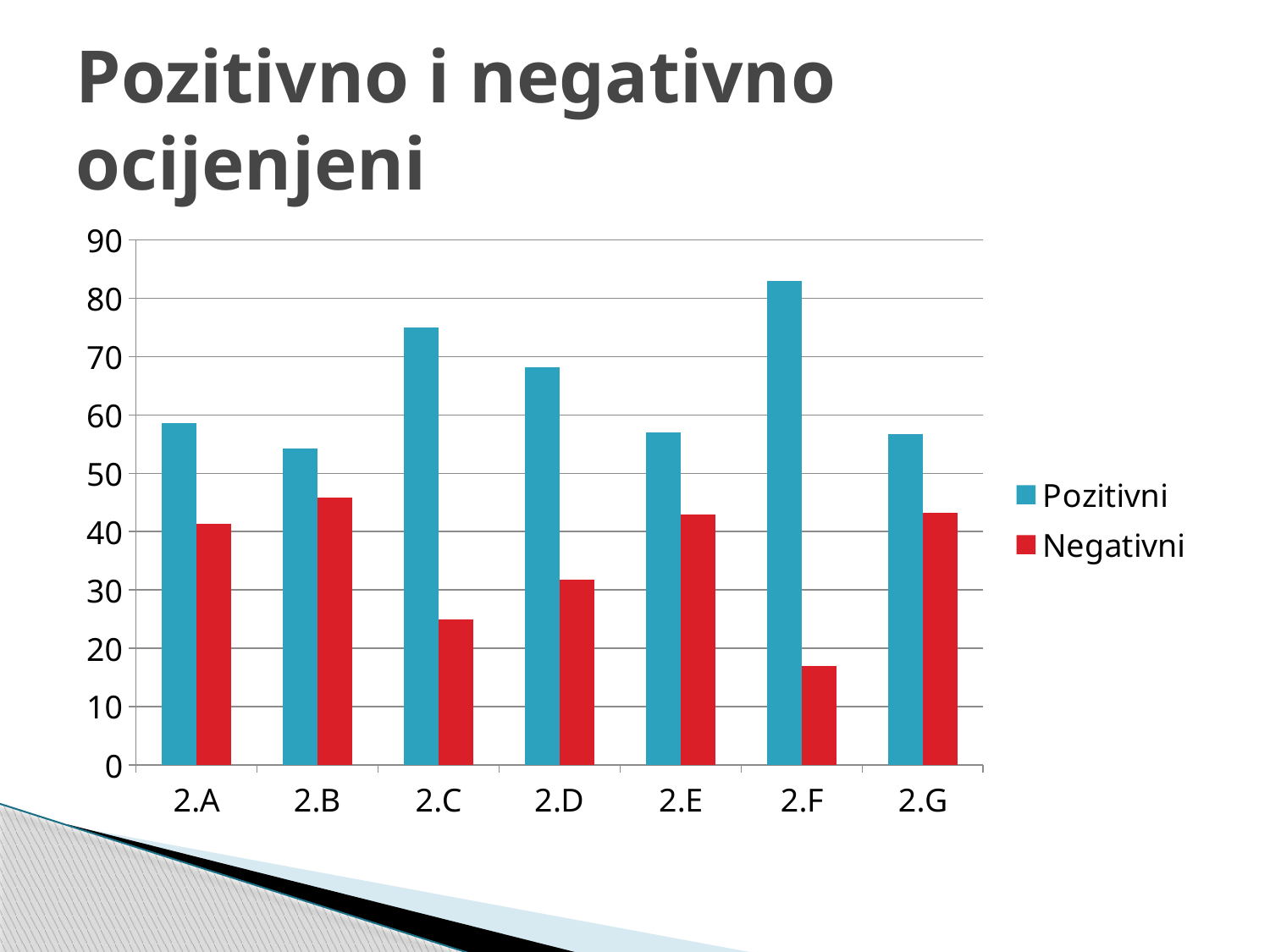
How many series does the legend list? 2 Which category has the lowest Negativni value? 2.F Which is larger, the Pozitivni value for 2.C or for 2.D? 2.C Is the Negativni value for 2.F greater or less than 20? less Is the Pozitivni value for 2.C greater or less than 70? greater Which is larger, the Negativni value for 2.B or for 2.C? 2.B Is the Pozitivni value for 2.F greater or less than 80? greater How many categories are shown on the x axis? 7 What is the title of the chart on the slide? Pozitivno i negativno ocijenjeni What kind of chart is shown on the slide? bar chart Which category has the highest Pozitivni value? 2.F